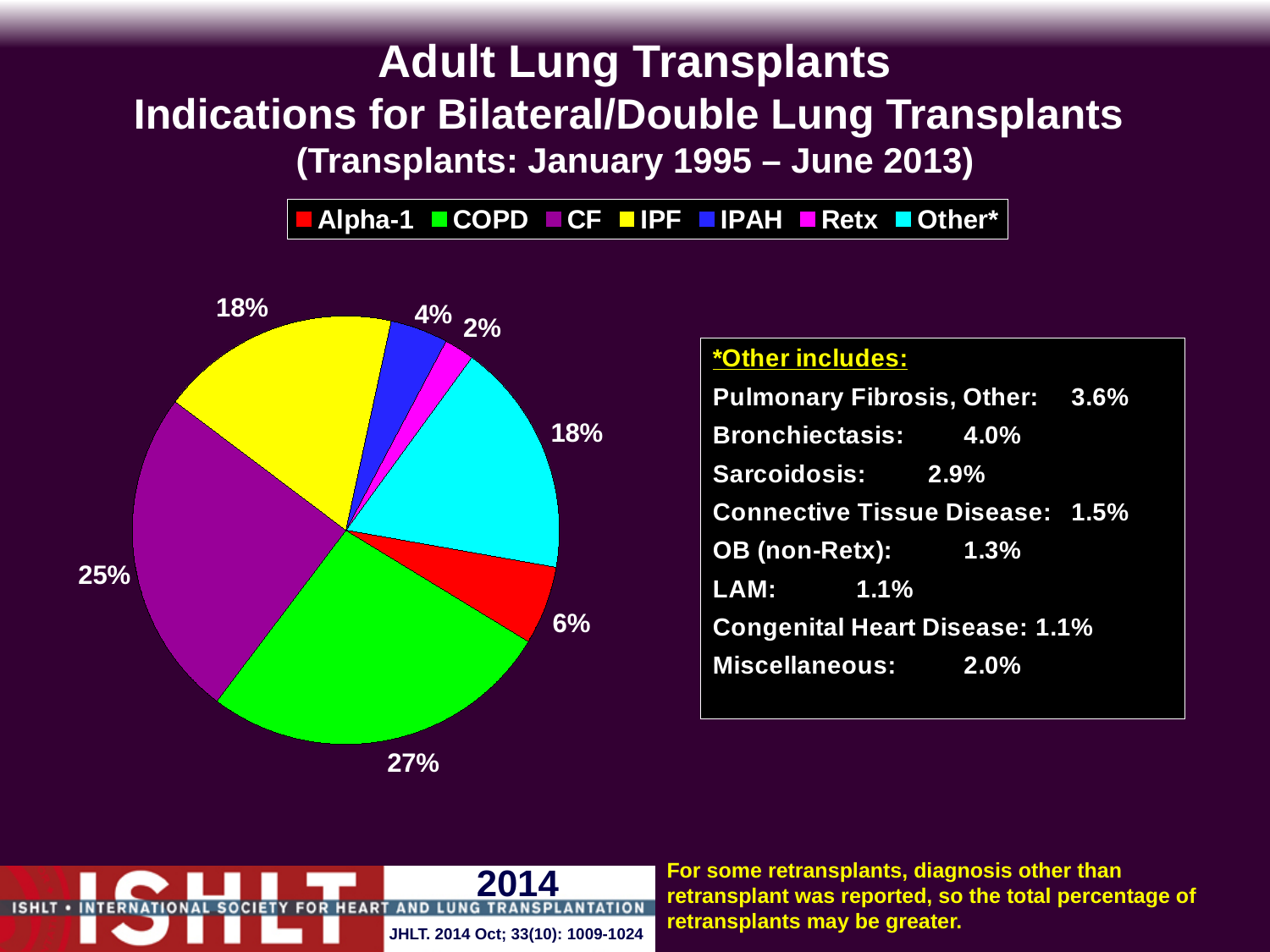
Which indication has the largest share of the pie? COPD What is the difference in percentage points between the COPD and CF slices? 2 Which indication has the smallest share of the pie? Retx What percentage of bilateral/double lung transplants is attributed to Alpha-1? 6% What percentage of bilateral/double lung transplants is attributed to COPD? 27% What colour represents Other* in the pie chart? cyan What percentage of bilateral/double lung transplants is attributed to IPAH? 4% What percentage of bilateral/double lung transplants is attributed to CF? 25% Which is larger, the share for IPF or the share for Alpha-1? IPF How many indication categories does the legend list? 7 What kind of chart is shown on the slide? pie chart What percentage of bilateral/double lung transplants is attributed to Retx? 2%